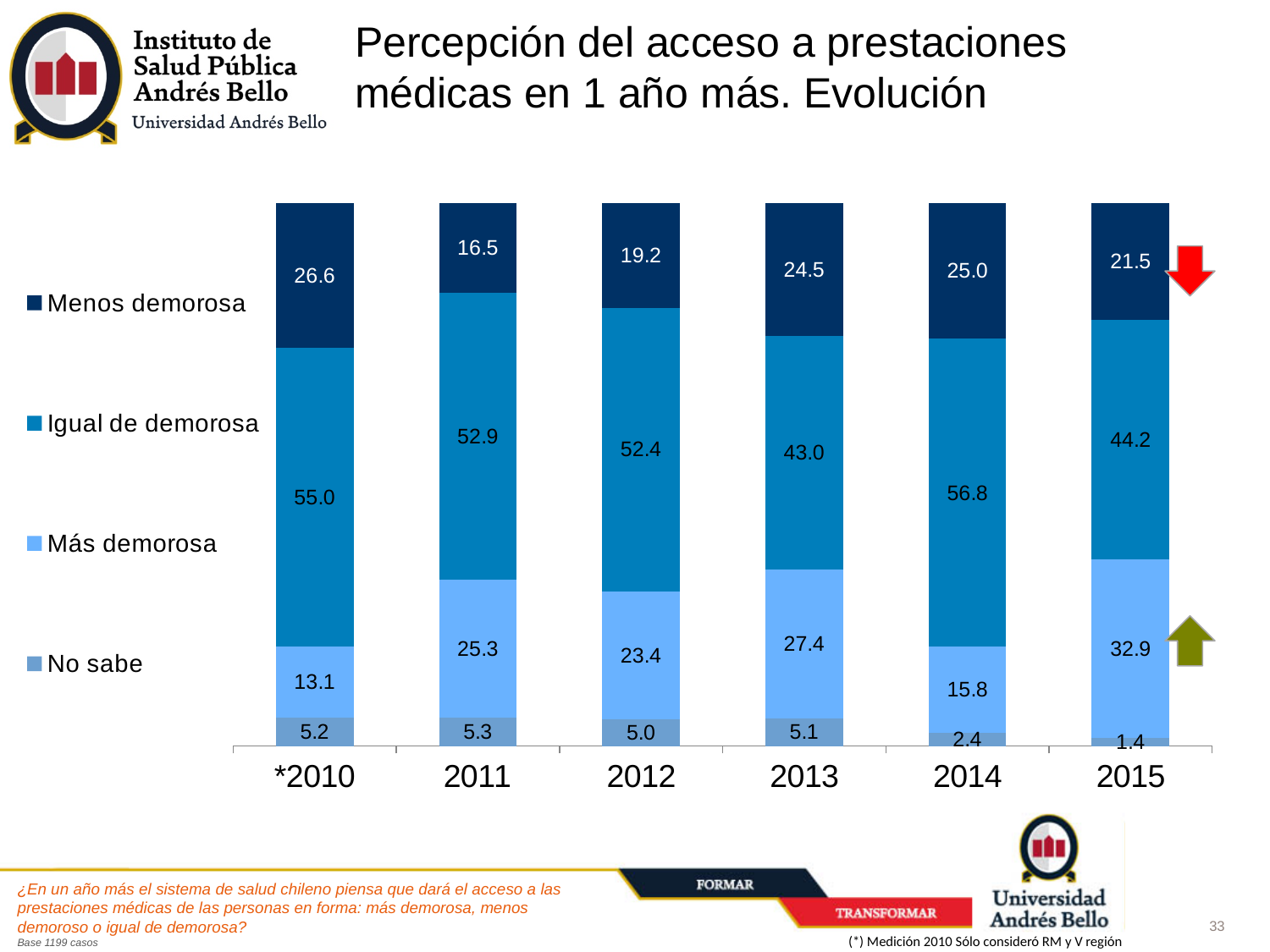
Which year has the larger Menos demorosa value, 2011 or 2013? 2013 What is the value for Más demorosa in 2015? 32.9 Does the No sabe value rise or fall from 2013 to 2015? Fall What kind of chart is shown on the slide? Stacked bar chart How many years are shown on the x axis? 6 What is the value for Menos demorosa in *2010? 26.6 In which year is the Más demorosa value highest? 2015 How many series does the legend list? 4 What is the difference between the Igual de demorosa values for 2014 and 2013? 13.8 In which year is the No sabe value lowest? 2015 What is the value for Igual de demorosa in 2012? 52.4 What is the total of the stacked bar for 2015? 100.0